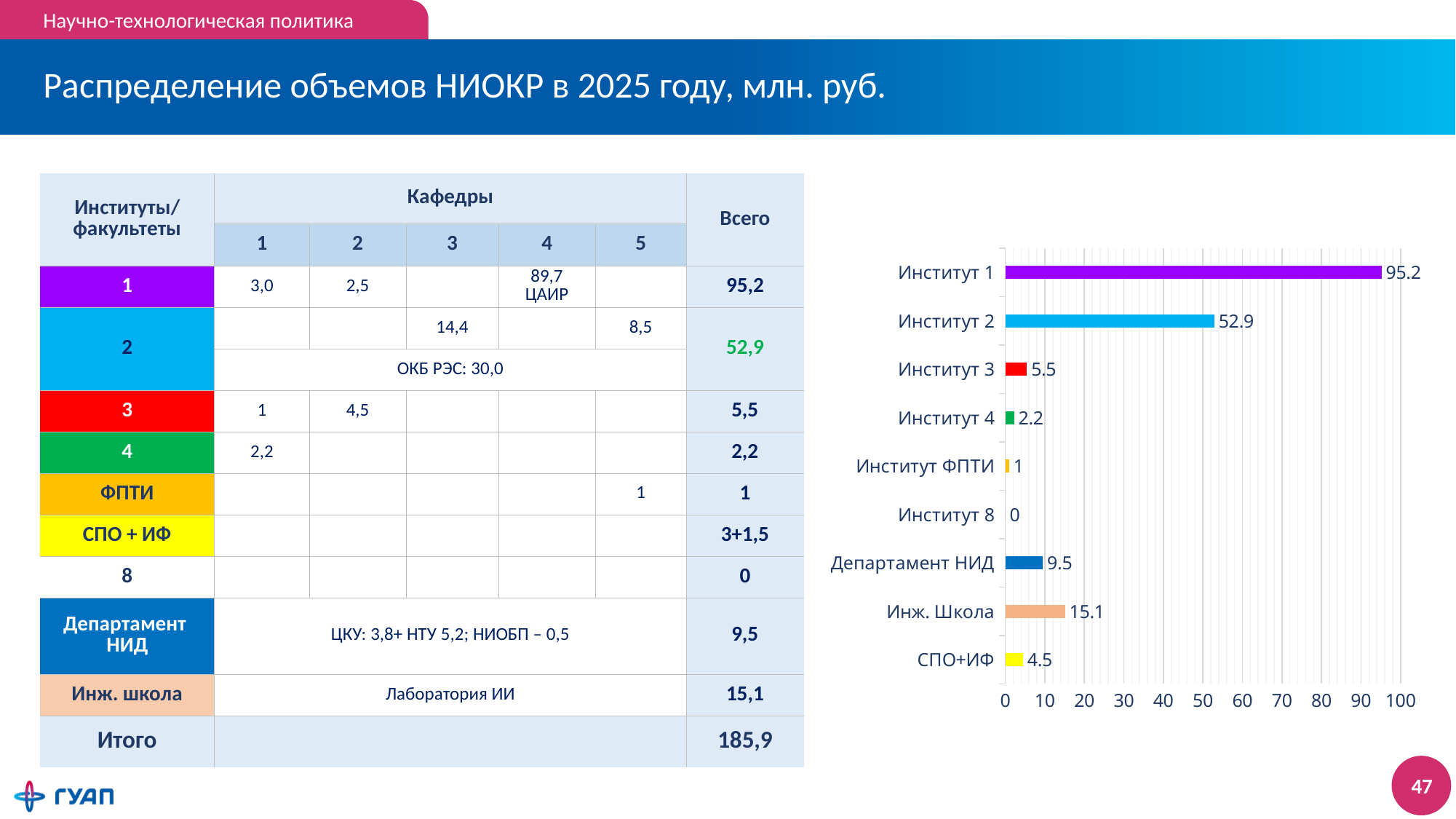
Is the value for Институт 2 in the bar chart greater or less than 50? greater Which category has the lowest value in the bar chart? Институт 8 What kind of chart is shown on the right of the slide? bar chart What is the difference between the values for Институт 1 and Институт 2 in the bar chart? 42.3 Which is larger in the bar chart: the value for Инж. Школа or the value for Департамент НИД? Инж. Школа What is the value for Инж. Школа in the bar chart? 15.1 What is the value for СПО+ИФ in the bar chart? 4.5 Which category has the highest value in the bar chart? Институт 1 What is the maximum value shown on the x axis of the bar chart? 100 What is the value for Департамент НИД in the bar chart? 9.5 What is the value for Институт 1 in the bar chart? 95.2 How many categories are shown in the bar chart? 9